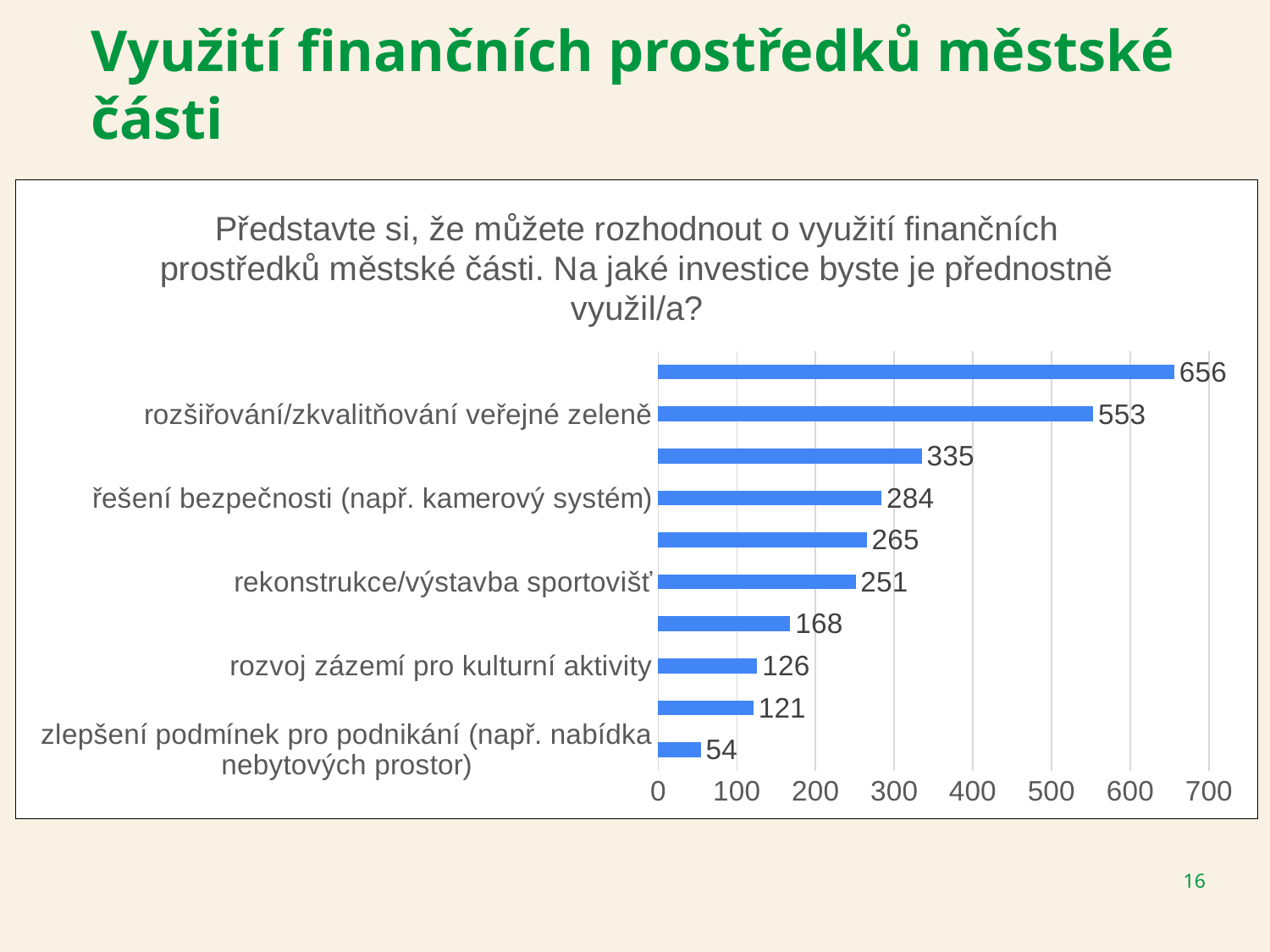
What is the difference between the values for "rozšiřování/zkvalitňování veřejné zeleně" and "řešení bezpečnosti (např. kamerový systém)"? 269 What kind of chart is shown on the slide? bar chart What is the highest value shown in the chart? 656 Which category has the lowest value? zlepšení podmínek pro podnikání (např. nabídka nebytových prostor) What is the value for "řešení bezpečnosti (např. kamerový systém)"? 284 What is the value for "rozšiřování/zkvalitňování veřejné zeleně"? 553 What is the value for "rozvoj zázemí pro kulturní aktivity"? 126 How many bars does the chart contain? 10 What is the value for "zlepšení podmínek pro podnikání (např. nabídka nebytových prostor)"? 54 What is the value for "rekonstrukce/výstavba sportovišť"? 251 Which is larger: the value for "rekonstrukce/výstavba sportovišť" or for "rozvoj zázemí pro kulturní aktivity"? rekonstrukce/výstavba sportovišť What is the maximum value shown on the horizontal axis? 700